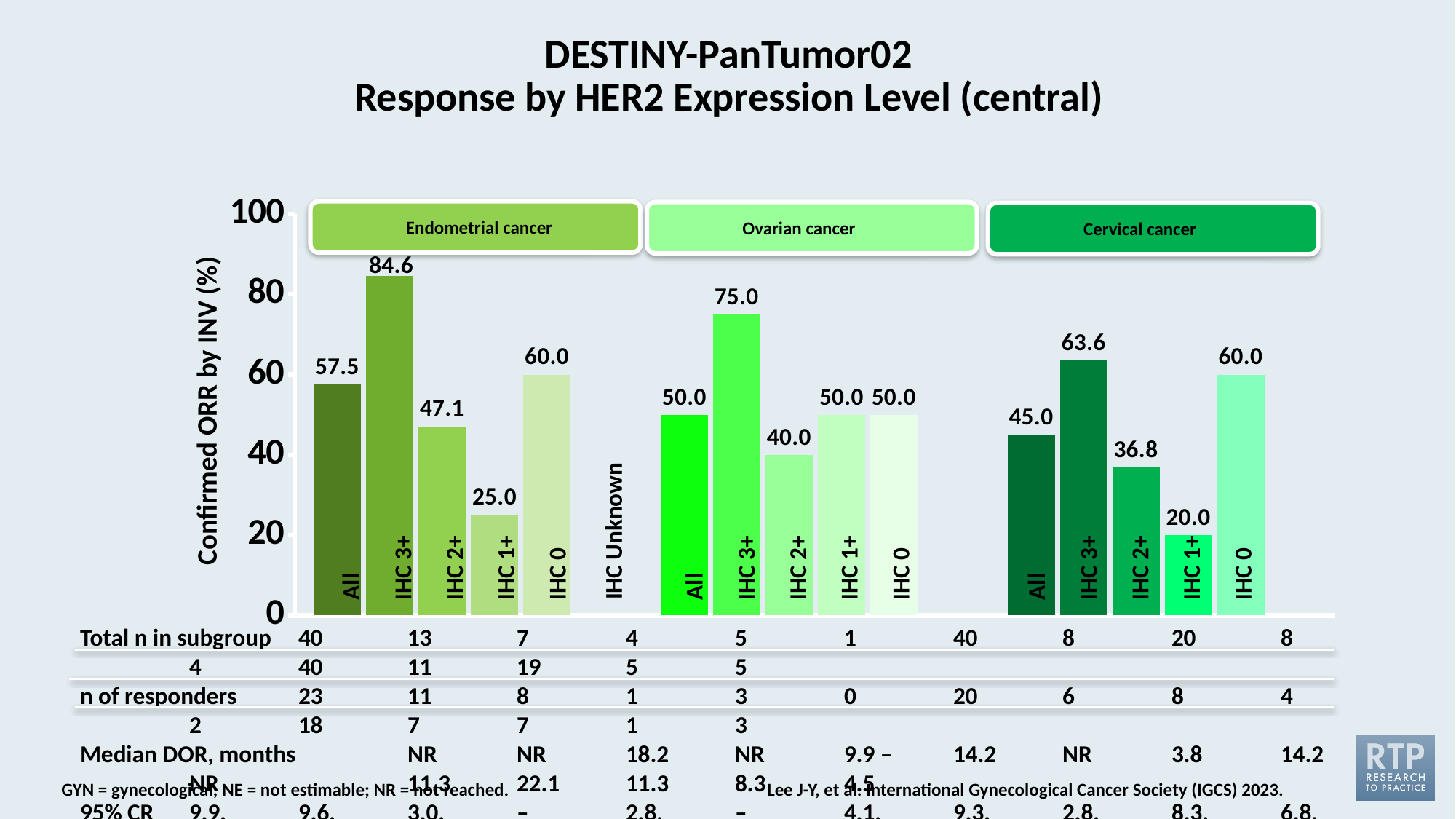
Which subgroup has the lowest confirmed ORR in the Endometrial cancer group? IHC 1+ What is the label of the y axis? Confirmed ORR by INV (%) What is the difference between the All confirmed ORR values for the Endometrial cancer and Cervical cancer groups? 12.5 What is the confirmed ORR for the All subgroup in the Ovarian cancer group? 50.0 What is the confirmed ORR for IHC 3+ in the Endometrial cancer group? 84.6 What type of chart is shown on the slide? bar chart What is the difference between the IHC 3+ and IHC 2+ confirmed ORR values in the Ovarian cancer group? 35.0 Which is larger: the confirmed ORR for IHC 0 in the Endometrial cancer group or for IHC 0 in the Ovarian cancer group? Endometrial cancer IHC 0 How many cancer types are shown in the chart? 3 Which subgroup has the highest confirmed ORR in the Cervical cancer group? IHC 3+ Is the confirmed ORR for IHC 1+ in the Cervical cancer group greater or less than 40? less What is the confirmed ORR for IHC 2+ in the Cervical cancer group? 36.8